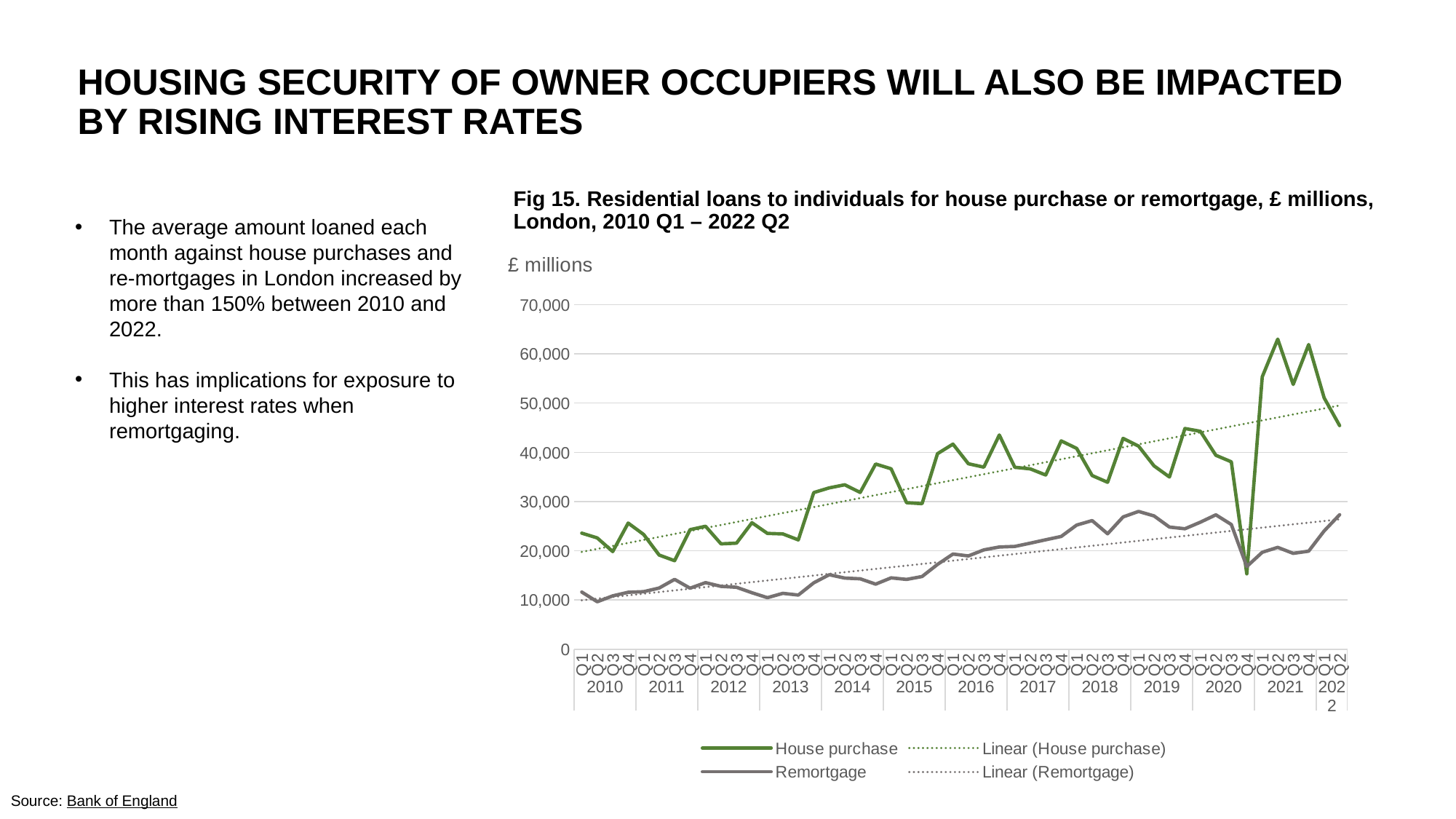
In Fig 15, in which quarter does the House purchase series fall to its lowest value after 2013? 2020 Q4 What is the source cited for Fig 15? Bank of England In Fig 15, is the House purchase value for 2020 Q4 greater or less than 20,000? less In Fig 15, is the House purchase value for 2021 Q2 greater or less than 60,000? greater In Fig 15, in which quarter does the House purchase series reach its highest value? 2021 Q2 What unit is shown on the vertical axis of Fig 15? £ millions How many entries does the legend of Fig 15 list? 4 In Fig 15, does the Remortgage series generally rise or fall from 2010 to 2022? rise What kind of chart is shown in Fig 15? line chart In Fig 15, is the Remortgage value for 2022 Q2 greater or less than 30,000? less